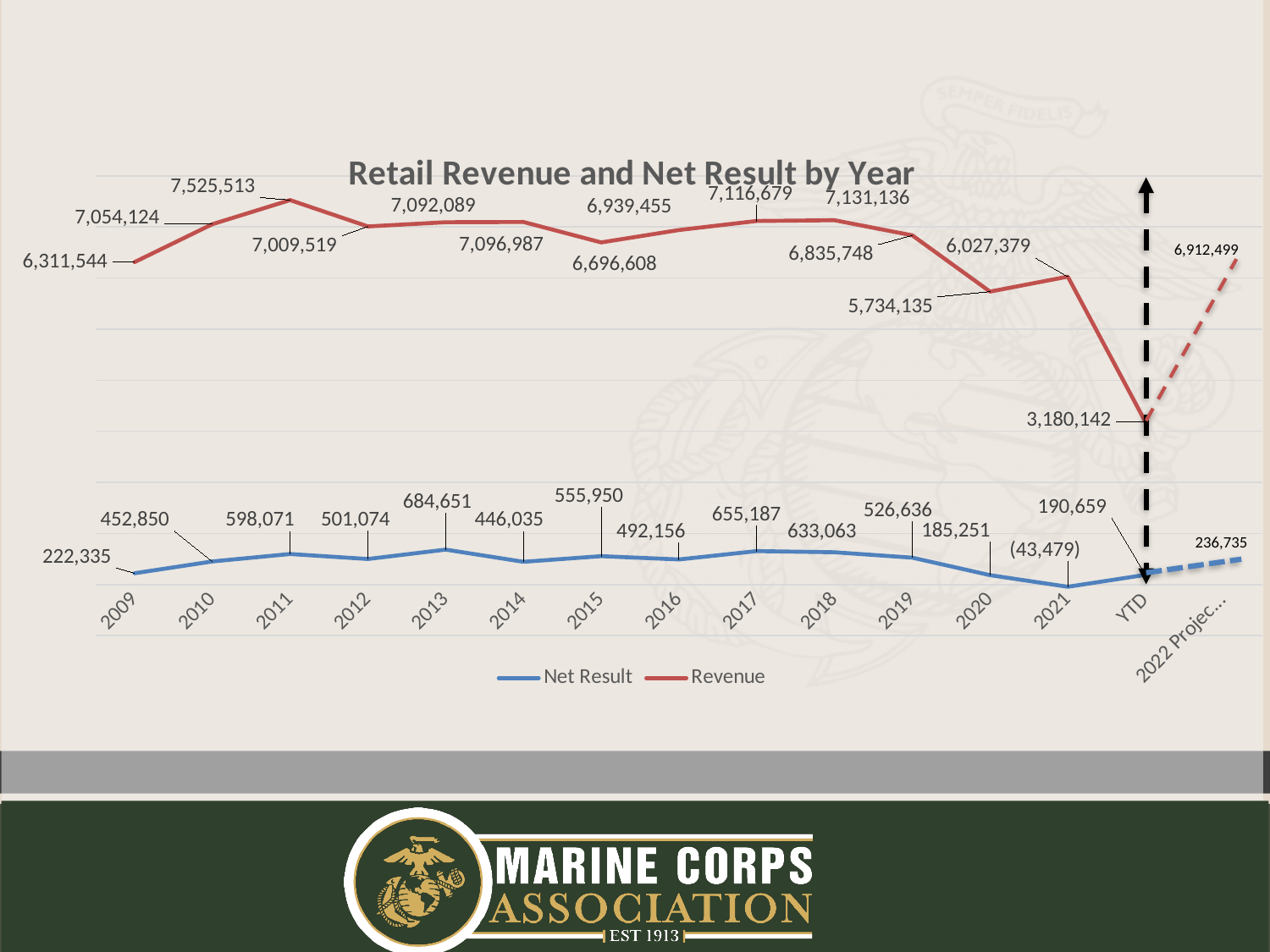
In which year is Revenue highest? 2011 Which is larger, the Net Result for 2017 or for 2018? 2017 In which year is Net Result lowest? 2021 What is the Net Result value for 2013? 684,651 What is the Net Result value for 2021? (43,479) What is the Revenue value for YTD? 3,180,142 What is the difference between the Revenue values for 2018 and 2019? 295,388 Does Revenue rise or fall from 2019 to 2020? Fall How many series does the legend list? 2 What is the title of the chart? Retail Revenue and Net Result by Year What is the Revenue value for 2011? 7,525,513 What kind of chart is this? Line chart